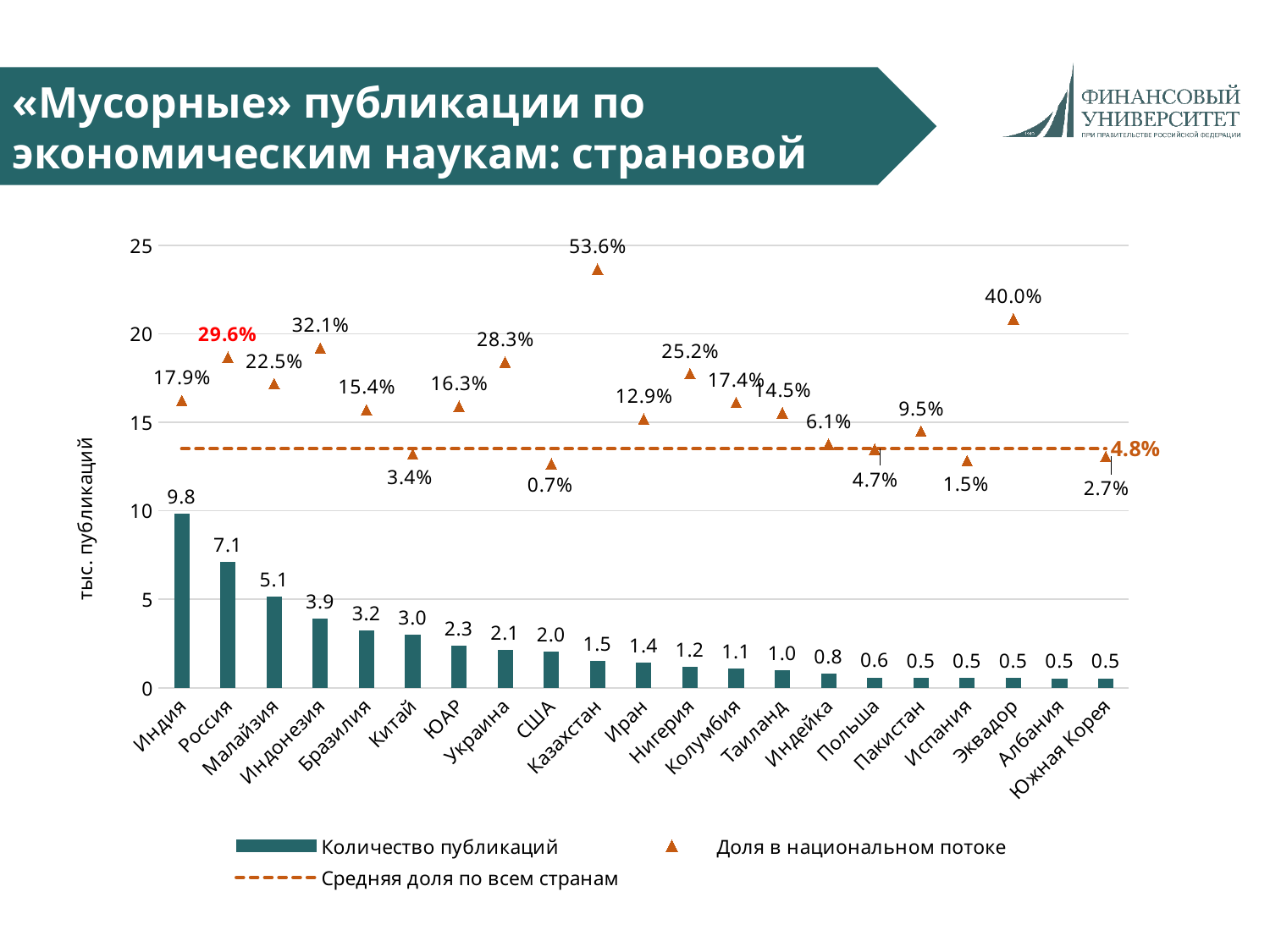
Which has more publications, Малайзия or Индонезия? Малайзия What is the difference in number of publications between Индия and Россия? 2.7 What is the number of publications for Россия? 7.1 Which country has the highest number of publications? Индия What is the number of publications (тыс. публикаций) for Индия? 9.8 How many series does the legend list? 3 What is the share in the national flow for Эквадор? 40.0% How many countries are shown on the x axis? 21 What is the share in the national flow (Доля в национальном потоке) for Казахстан? 53.6% Which country has the lowest share in the national flow? США What is the value of the average share across all countries (Средняя доля по всем странам) shown by the dashed line? 4.8%